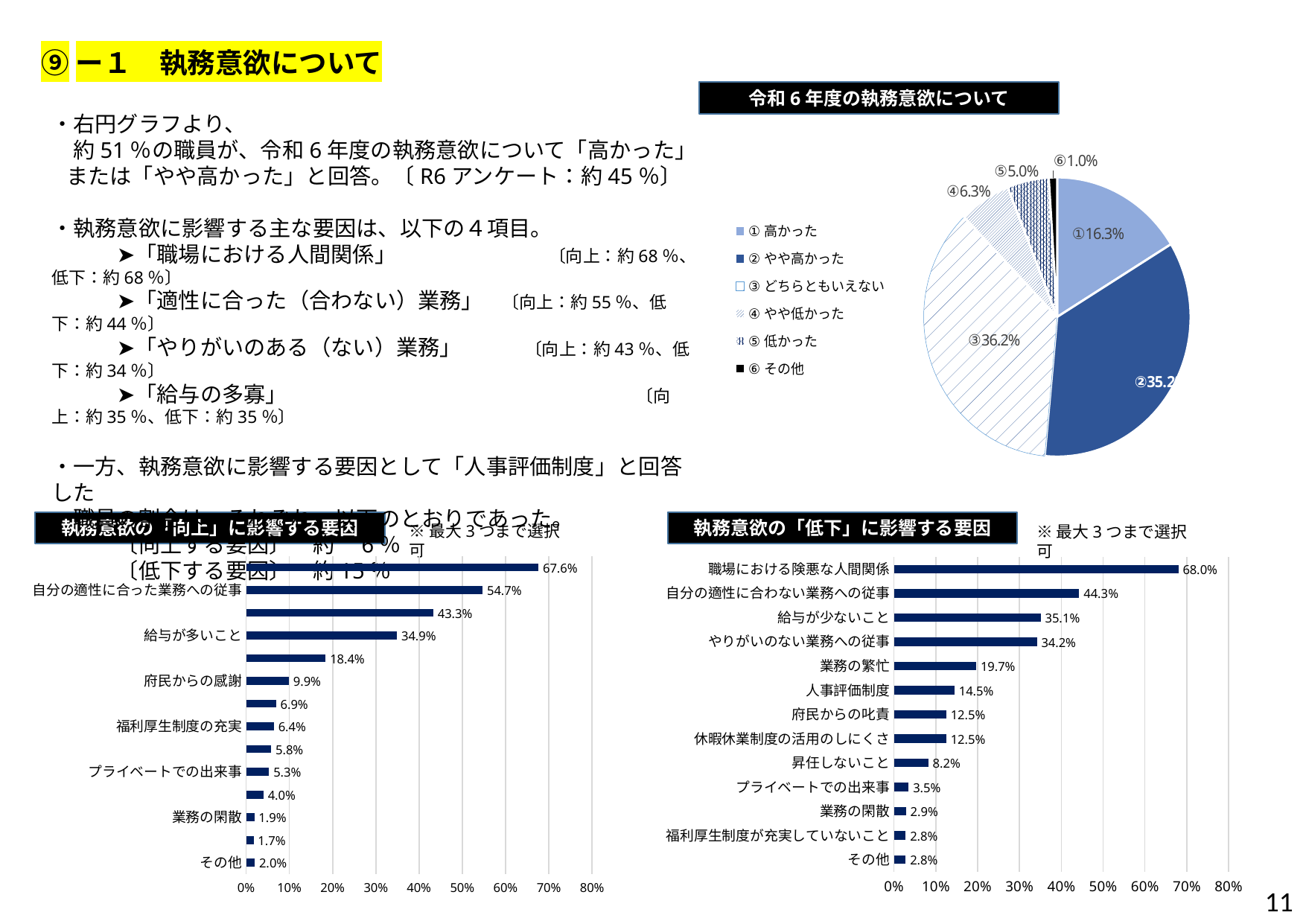
How many entries does the legend of the pie chart 令和6年度の執務意欲について list? 6 In the pie chart 令和6年度の執務意欲について, what percentage is shown for ③ どちらともいえない? 36.2% In the pie chart 令和6年度の執務意欲について, what percentage is shown for ① 高かった? 16.3% In the bar chart 執務意欲の「低下」に影響する要因, how many bars are plotted? 13 In the bar chart 執務意欲の「低下」に影響する要因, which category has the highest value? 職場における険悪な人間関係 In the bar chart 執務意欲の「低下」に影響する要因, what is the value for 人事評価制度? 14.5% In the bar chart 執務意欲の「低下」に影響する要因, what is the difference between 自分の適性に合わない業務への従事 and 給与が少ないこと? 9.2% What kind of chart is 執務意欲の「向上」に影響する要因? bar chart In the bar chart 執務意欲の「低下」に影響する要因, what is the value for 職場における険悪な人間関係? 68.0% In the bar chart 執務意欲の「向上」に影響する要因, what is the value for 自分の適性に合った業務への従事? 54.7% In the pie chart 令和6年度の執務意欲について, which category has the smallest slice? ⑥ その他 In the bar chart 執務意欲の「向上」に影響する要因, which is larger, 給与が多いこと or 府民からの感謝? 給与が多いこと